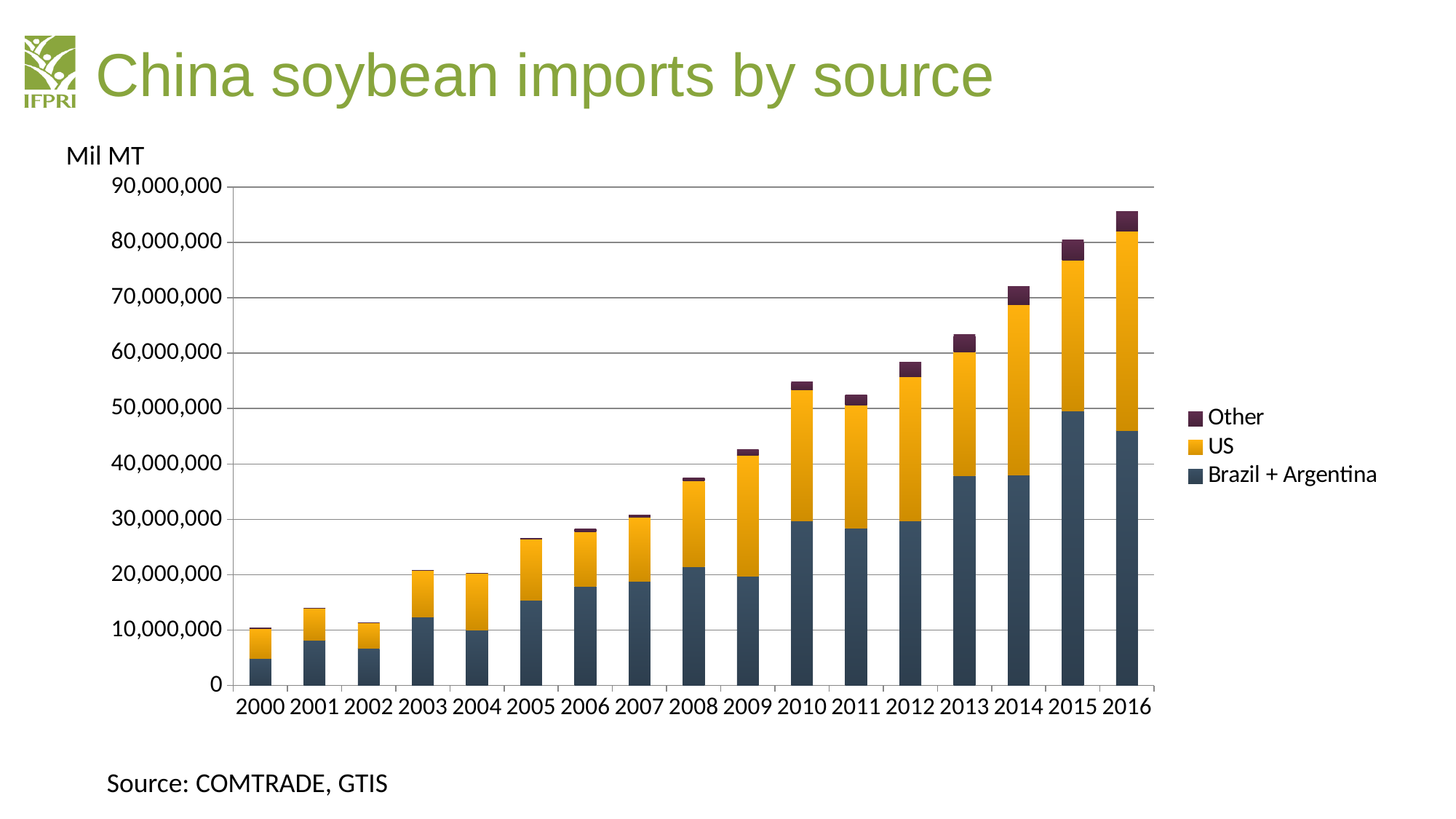
Which year has the larger total imports, 2013 or 2014? 2014 What kind of chart is shown on the slide? Stacked bar chart How many series does the legend list? 3 What is the title of the chart? China soybean imports by source How many years are shown along the x axis? 17 Is the total value for 2016 greater or less than 80,000,000? greater Which year has the highest total soybean imports? 2016 Is the total value for 2008 greater or less than 40,000,000? less Do total soybean imports generally rise or fall from 2000 to 2016? rise Is the Brazil + Argentina value for 2016 greater or less than 50,000,000? less Which year has the lowest total soybean imports? 2000